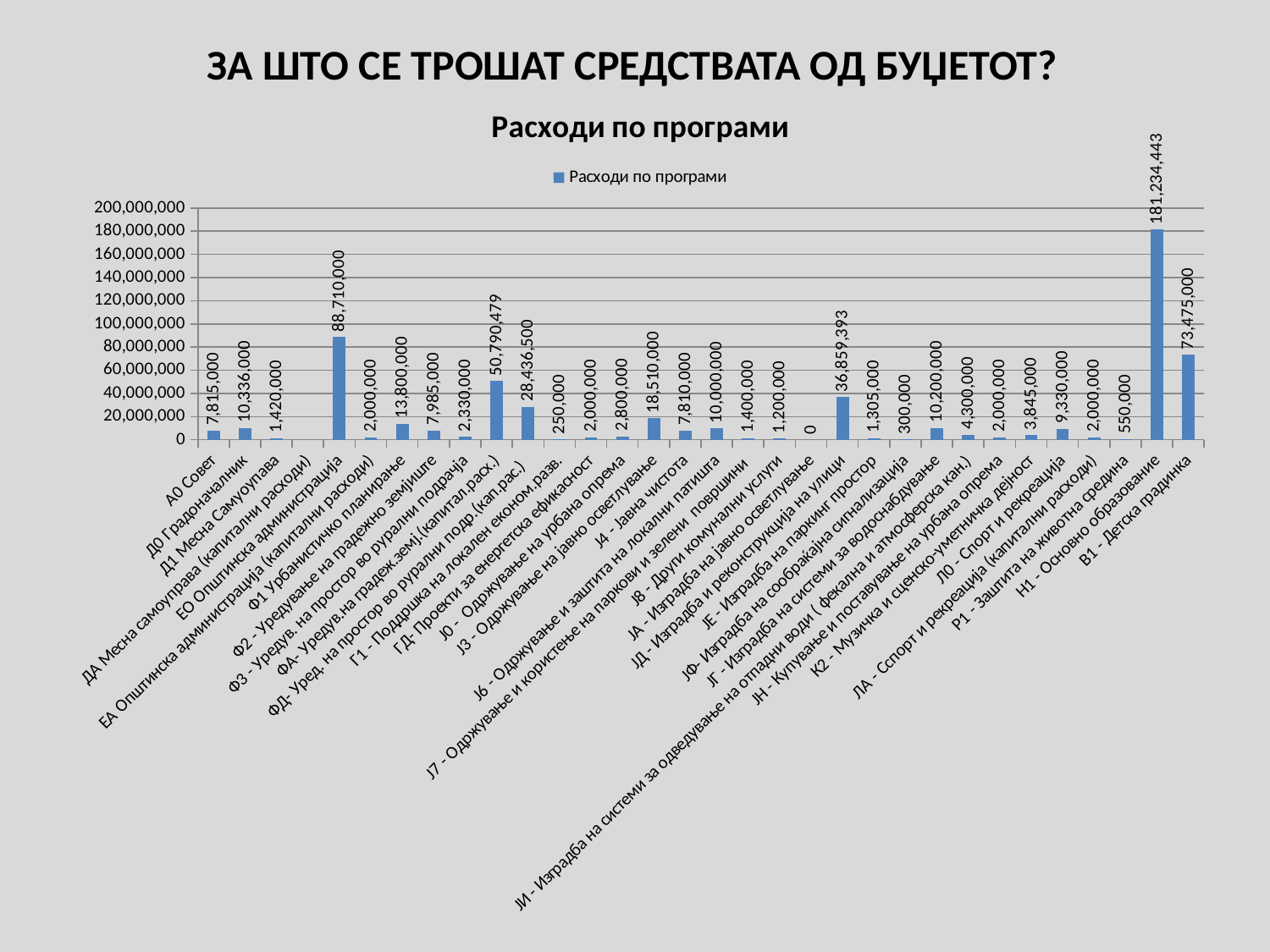
What is the difference between the values for Н1 - Основно образование and В1 - Детска градинка? 107,759,443 What is the value for В1 - Детска градинка? 73,475,000 What is the value for А0 Совет? 7,815,000 What is the value for Н1 - Основно образование? 181,234,443 Is the value for ЕО Општинска администрација greater or less than 80,000,000? greater What is the title of the chart? Расходи по програми What is the value for Д0 Градоначалник? 10,336,000 Which program has the highest expenditure? Н1 - Основно образование What type of chart is shown on the slide? bar chart Which is larger, the value for Н1 - Основно образование or the value for В1 - Детска градинка? Н1 - Основно образование What is the value for ЕО Општинска администрација? 88,710,000 How many series does the legend list? 1